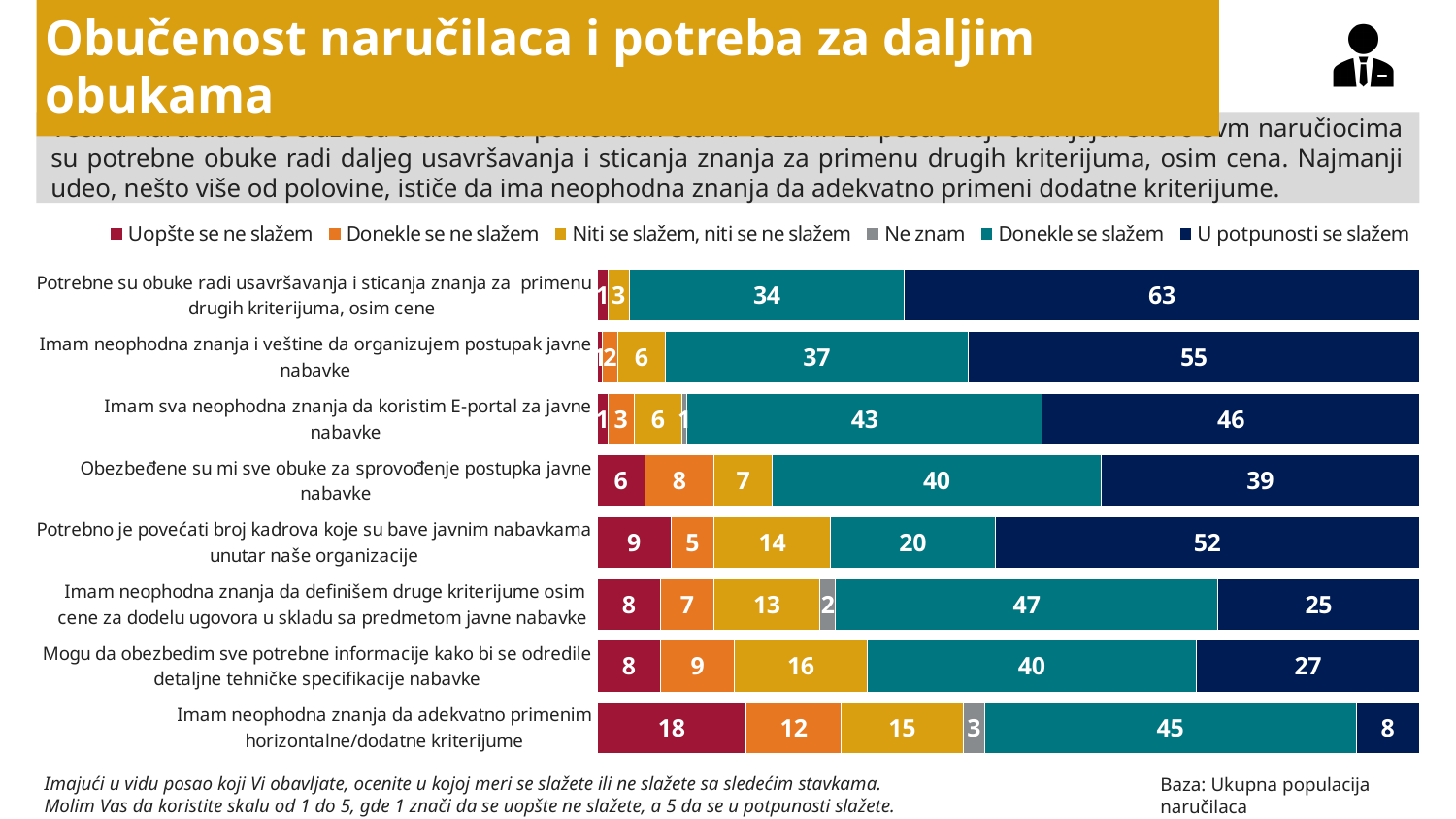
How many series does the legend list? 6 What is the value of "U potpunosti se slažem" for the statement "Potrebne su obuke radi usavršavanja i sticanja znanja za primenu drugih kriterijuma, osim cene"? 63 What is the value of "Uopšte se ne slažem" for the statement "Imam neophodna znanja da adekvatno primenim horizontalne/dodatne kriterijume"? 18 What is the value of "Donekle se slažem" for the statement "Imam sva neophodna znanja da koristim E-portal za javne nabavke"? 43 Which statement has the highest value for "U potpunosti se slažem"? Potrebne su obuke radi usavršavanja i sticanja znanja za primenu drugih kriterijuma, osim cene Which statement has the lowest value for "U potpunosti se slažem"? Imam neophodna znanja da adekvatno primenim horizontalne/dodatne kriterijume What kind of chart is shown on the slide? bar chart Which is larger: the "Donekle se slažem" value for "Imam neophodna znanja da definišem druge kriterijume osim cene..." or for "Mogu da obezbedim sve potrebne informacije..."? Imam neophodna znanja da definišem druge kriterijume osim cene... (47) What is the total of the stacked bar for "Obezbeđene su mi sve obuke za sprovođenje postupka javne nabavke"? 100 How many statements (categories) are plotted in the chart? 8 What is the difference between the "U potpunosti se slažem" values for "Potrebne su obuke radi usavršavanja..." (63) and "Imam neophodna znanja i veštine da organizujem postupak javne nabavke" (55)? 8 Which legend entry is shown in dark navy blue? U potpunosti se slažem